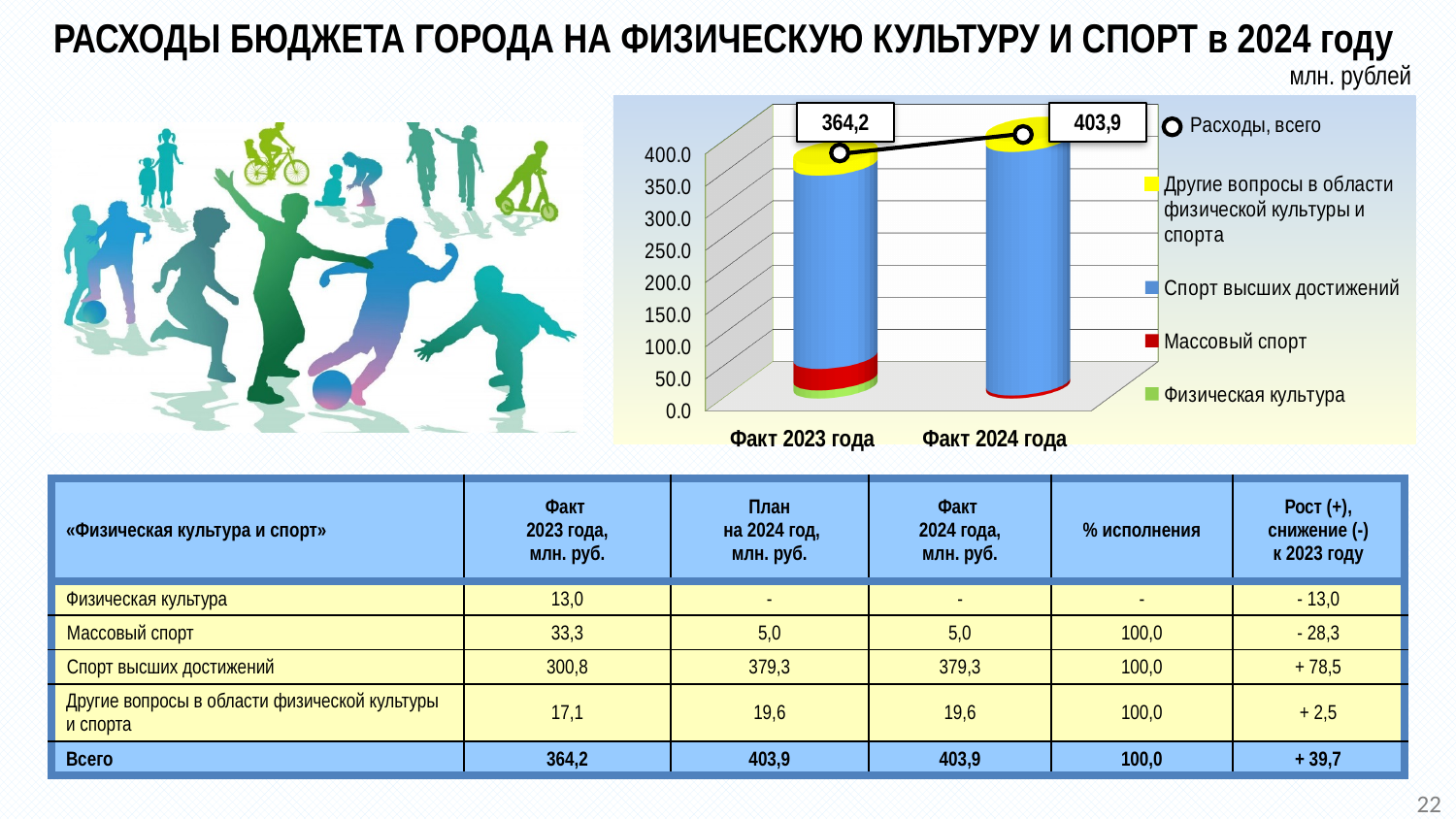
How many categories are shown on the x axis of the chart? 2 By how much does «Расходы, всего» for Факт 2024 года exceed that for Факт 2023 года? 39,7 Which category has the lowest total expenditure? Факт 2023 года Is the total value for Факт 2023 года greater or less than 350.0? greater Which category has the highest total expenditure? Факт 2024 года Is the total value for Факт 2024 года greater or less than 400.0? greater Which is larger, «Расходы, всего» for Факт 2023 года or for Факт 2024 года? Факт 2024 года What is the value of «Расходы, всего» for Факт 2023 года? 364,2 How many entries does the chart legend list? 5 What kind of chart is shown on the slide? Stacked bar chart with a line What is the value of «Расходы, всего» for Факт 2024 года? 403,9 Does the total expenditure rise or fall from Факт 2023 года to Факт 2024 года? rise